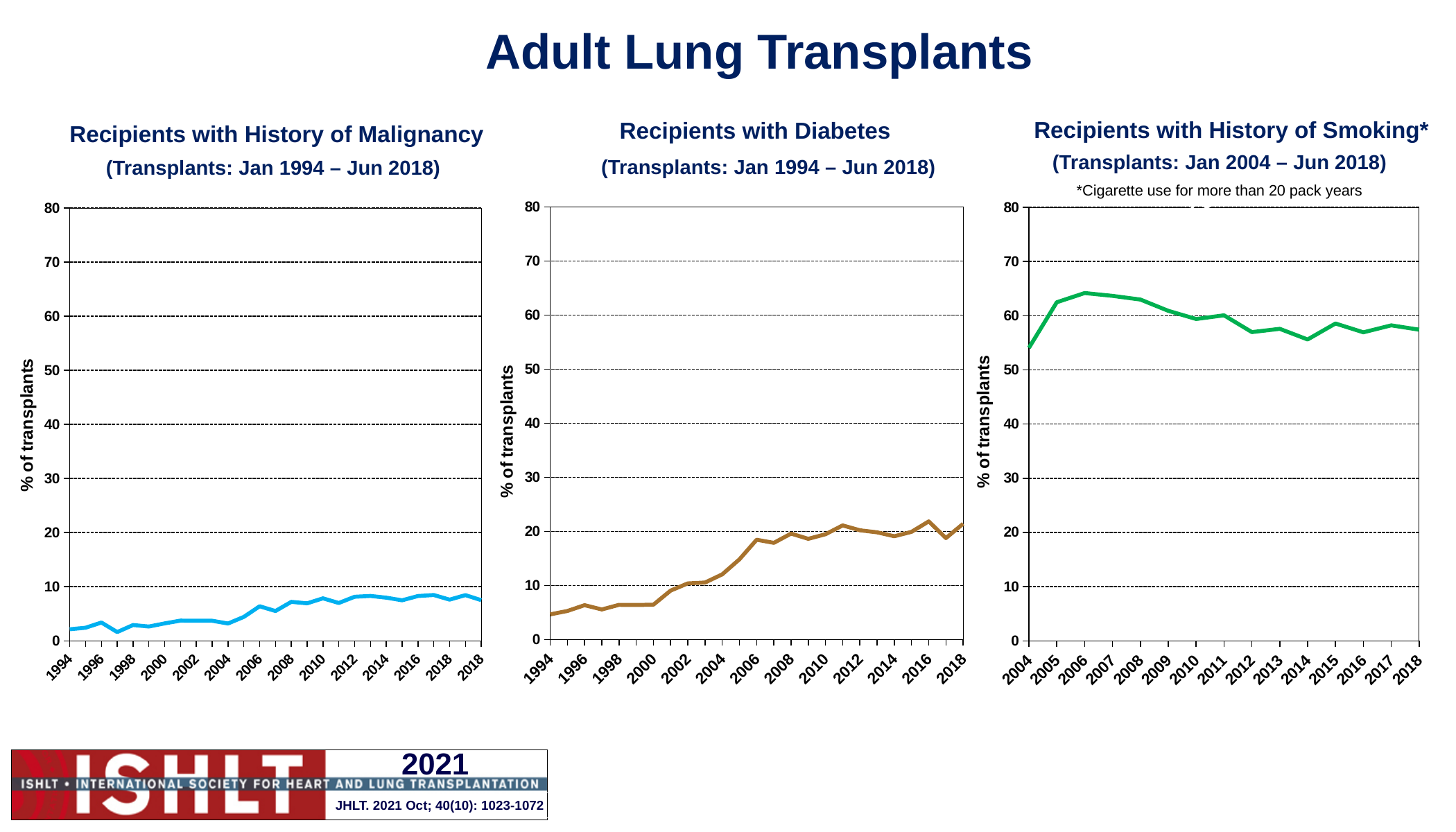
In the 'Recipients with History of Smoking*' chart, which year has the lowest value? 2004 In the 'Recipients with Diabetes' chart, is the value for 2018 greater or less than 20? greater In the 'Recipients with History of Malignancy' chart, is the value for 2018 greater or less than 10? less What is the y-axis label of the 'Recipients with Diabetes' chart? % of transplants In the 'Recipients with History of Smoking*' chart, is the value for 2006 greater or less than 60? greater In the 'Recipients with History of Smoking*' chart, which is larger, the value for 2006 or the value for 2004? 2006 How many years are plotted on the x axis of the 'Recipients with History of Smoking*' chart? 15 In the 'Recipients with Diabetes' chart, do the values generally rise or fall from 1994 to 2018? rise What kind of chart is the 'Recipients with History of Malignancy' chart? line chart In the 'Recipients with History of Malignancy' chart, do the values generally rise or fall from 1994 to 2018? rise